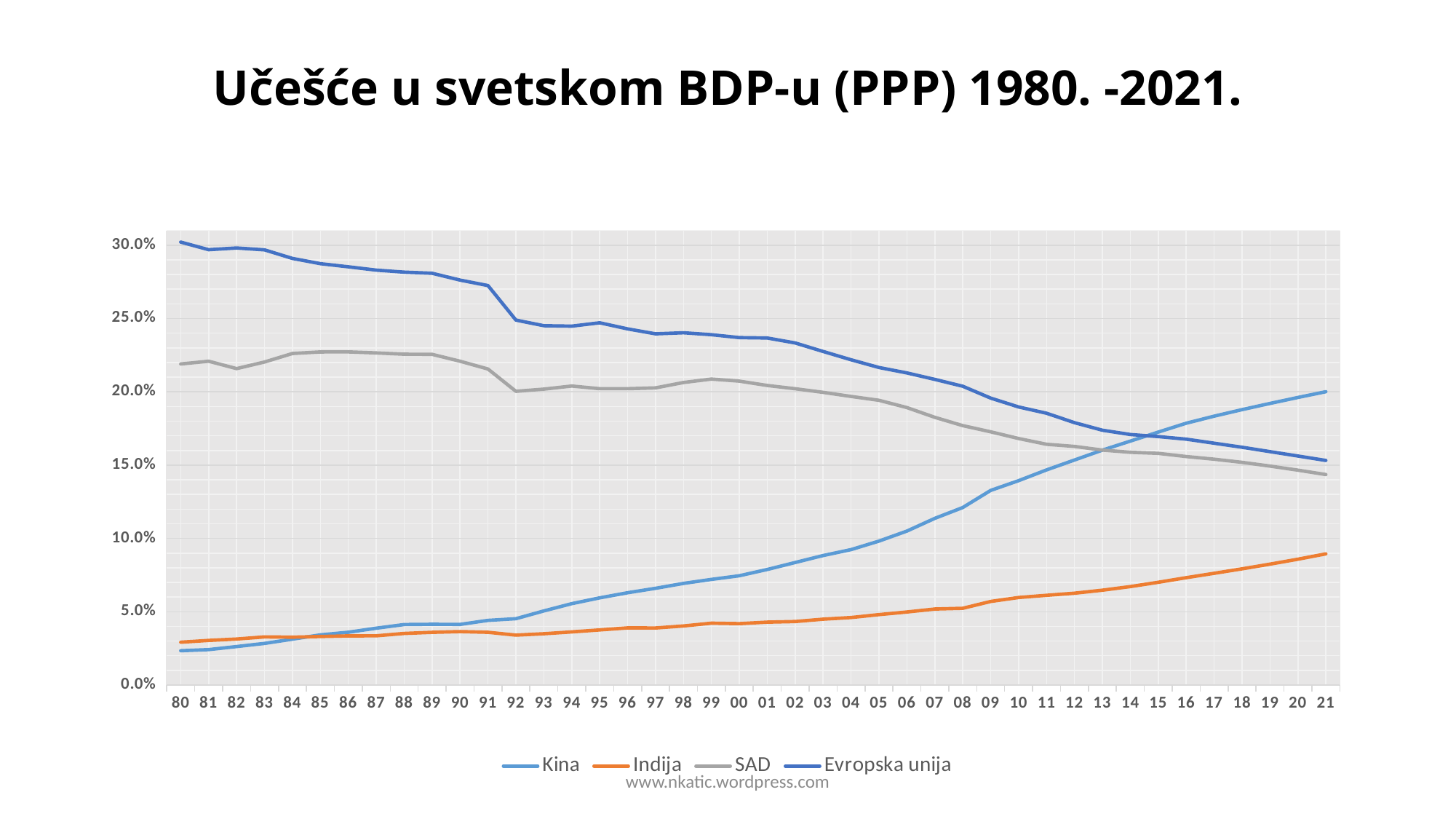
Which series has the highest value in 21? Kina Which series has the highest value in 80? Evropska unija How many years (points) are plotted along the x axis? 42 Does the value for Kina rise or fall from 80 to 21? rise How many series does the legend list? 4 Which series has the lowest value in 21? Indija Does the value for Evropska unija rise or fall from 80 to 21? fall What kind of chart is shown on the slide? line chart Is the value for Kina in 80 greater or less than 5.0%? less In 21, which is larger, the value for Kina or the value for SAD? Kina What is the title of the chart? Učešće u svetskom BDP-u (PPP) 1980. -2021. Is the value for SAD in 21 greater or less than 15.0%? less